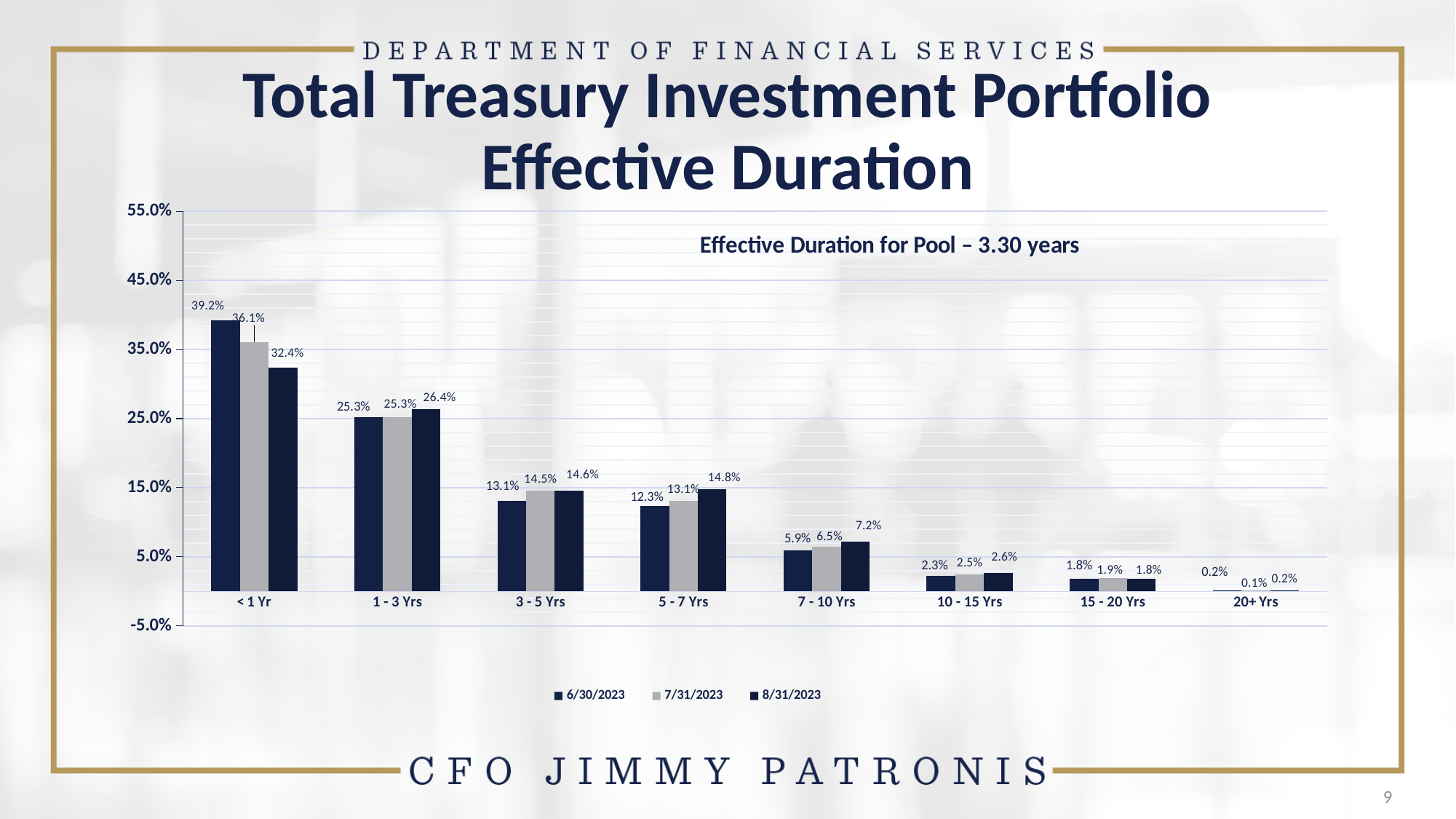
Do the 8/31/2023 values generally rise or fall moving from < 1 Yr to 20+ Yrs? Fall What effective duration for the pool is stated on the chart? 3.30 years What kind of chart is shown on the slide? Bar chart How many series does the legend list? 3 Which category has the highest value in the 8/31/2023 series? < 1 Yr What is the value for 5 - 7 Yrs in the 8/31/2023 series? 14.8% What is the value for 7 - 10 Yrs in the 7/31/2023 series? 6.5% How many maturity categories are shown on the x axis? 8 What is the value for < 1 Yr in the 6/30/2023 series? 39.2% Which category has the lowest value in the 7/31/2023 series? 20+ Yrs What is the difference between the 6/30/2023 and 8/31/2023 values for < 1 Yr? 6.8% Which is larger for 3 - 5 Yrs: the 6/30/2023 value or the 7/31/2023 value? 7/31/2023